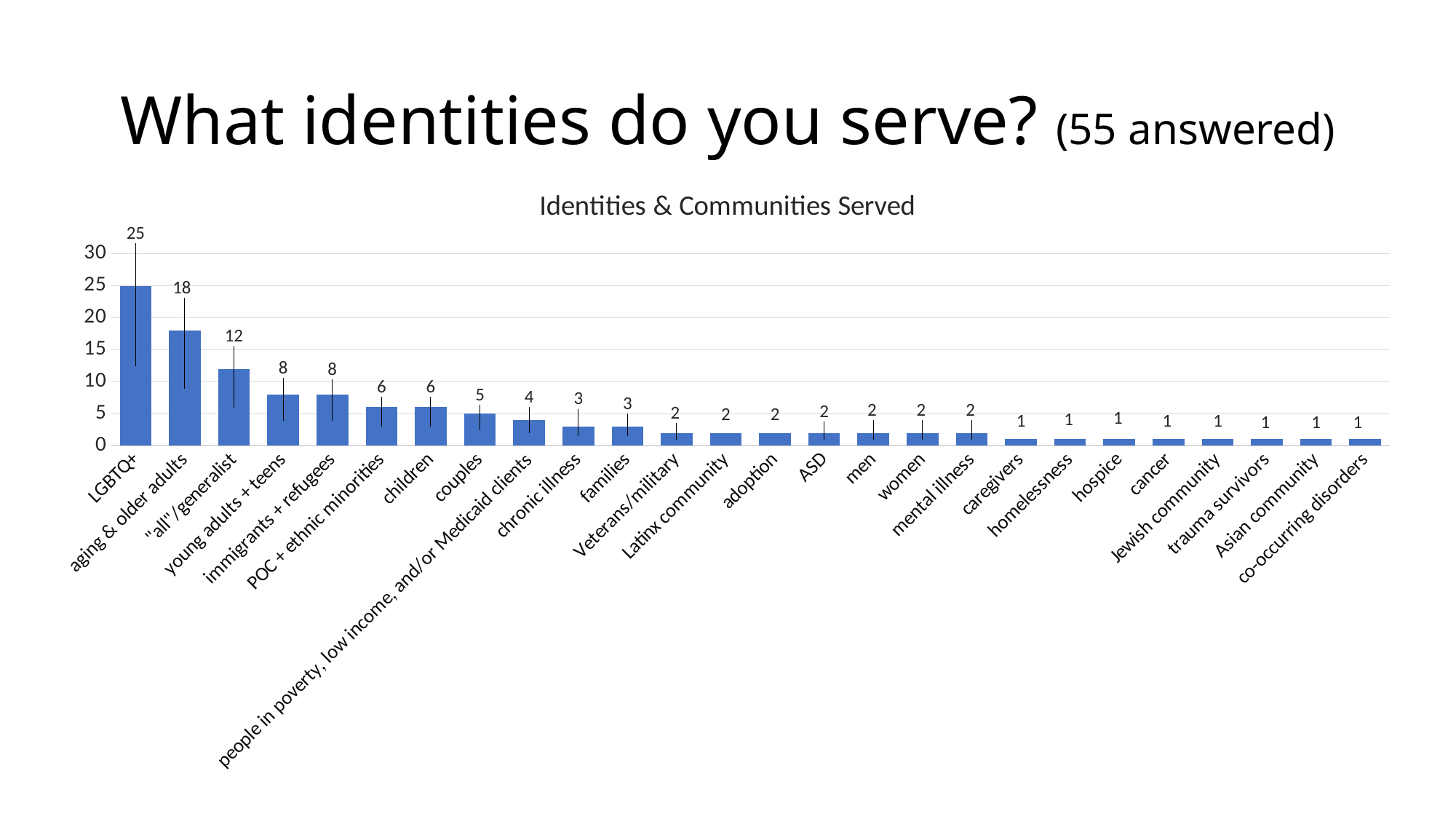
What is the value for LGBTQ+? 25 What kind of chart is shown on the slide? bar chart Which is larger, the value for children or the value for chronic illness? children What is the value for Veterans/military? 2 Which category has the highest value? LGBTQ+ What is the difference between the values for LGBTQ+ and aging & older adults? 7 Is the value for "all"/generalist greater or less than 10? greater What is the value for aging & older adults? 18 What is the title of the chart? Identities & Communities Served What is the value for "all"/generalist? 12 How many categories are shown on the x axis? 26 What is the value for couples? 5